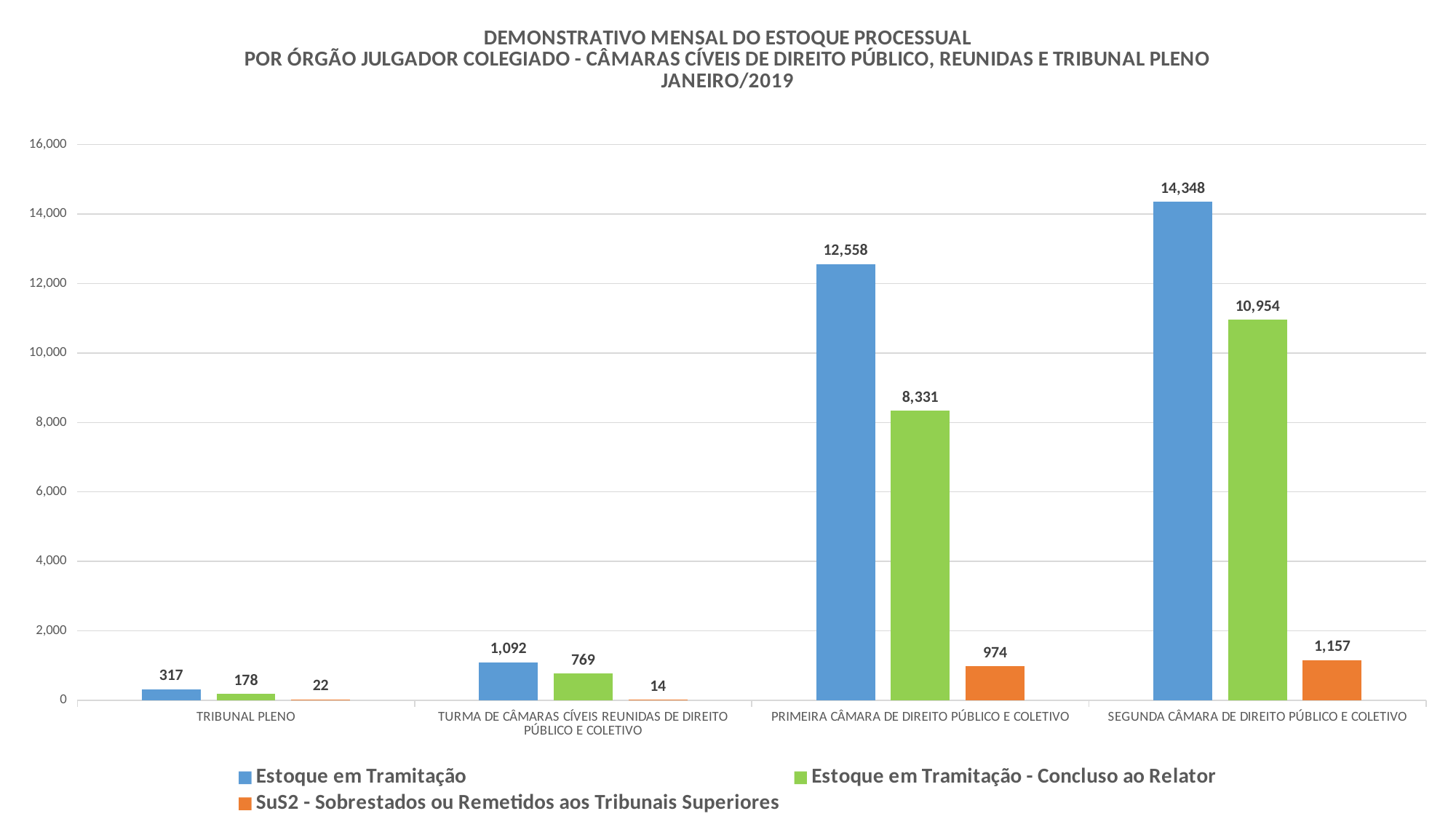
Which is larger: the Estoque em Tramitação - Concluso ao Relator value for TURMA DE CÂMARAS CÍVEIS REUNIDAS or for TRIBUNAL PLENO? TURMA DE CÂMARAS CÍVEIS REUNIDAS DE DIREITO PÚBLICO E COLETIVO What is the SuS2 - Sobrestados ou Remetidos aos Tribunais Superiores value for TRIBUNAL PLENO? 22 What is the value of Estoque em Tramitação for SEGUNDA CÂMARA DE DIREITO PÚBLICO E COLETIVO? 14,348 Which colour represents the SuS2 - Sobrestados ou Remetidos aos Tribunais Superiores series? orange Which category has the lowest SuS2 - Sobrestados ou Remetidos aos Tribunais Superiores value? TURMA DE CÂMARAS CÍVEIS REUNIDAS DE DIREITO PÚBLICO E COLETIVO Is the Estoque em Tramitação - Concluso ao Relator value for SEGUNDA CÂMARA DE DIREITO PÚBLICO E COLETIVO greater or less than 10,000? greater What is the difference between the Estoque em Tramitação values for SEGUNDA CÂMARA and PRIMEIRA CÂMARA DE DIREITO PÚBLICO E COLETIVO? 1,790 What kind of chart is shown on the slide? bar chart What is the value of Estoque em Tramitação - Concluso ao Relator for PRIMEIRA CÂMARA DE DIREITO PÚBLICO E COLETIVO? 8,331 How many series does the legend list? 3 How many categories are shown on the x axis? 4 Which category has the highest Estoque em Tramitação value? SEGUNDA CÂMARA DE DIREITO PÚBLICO E COLETIVO